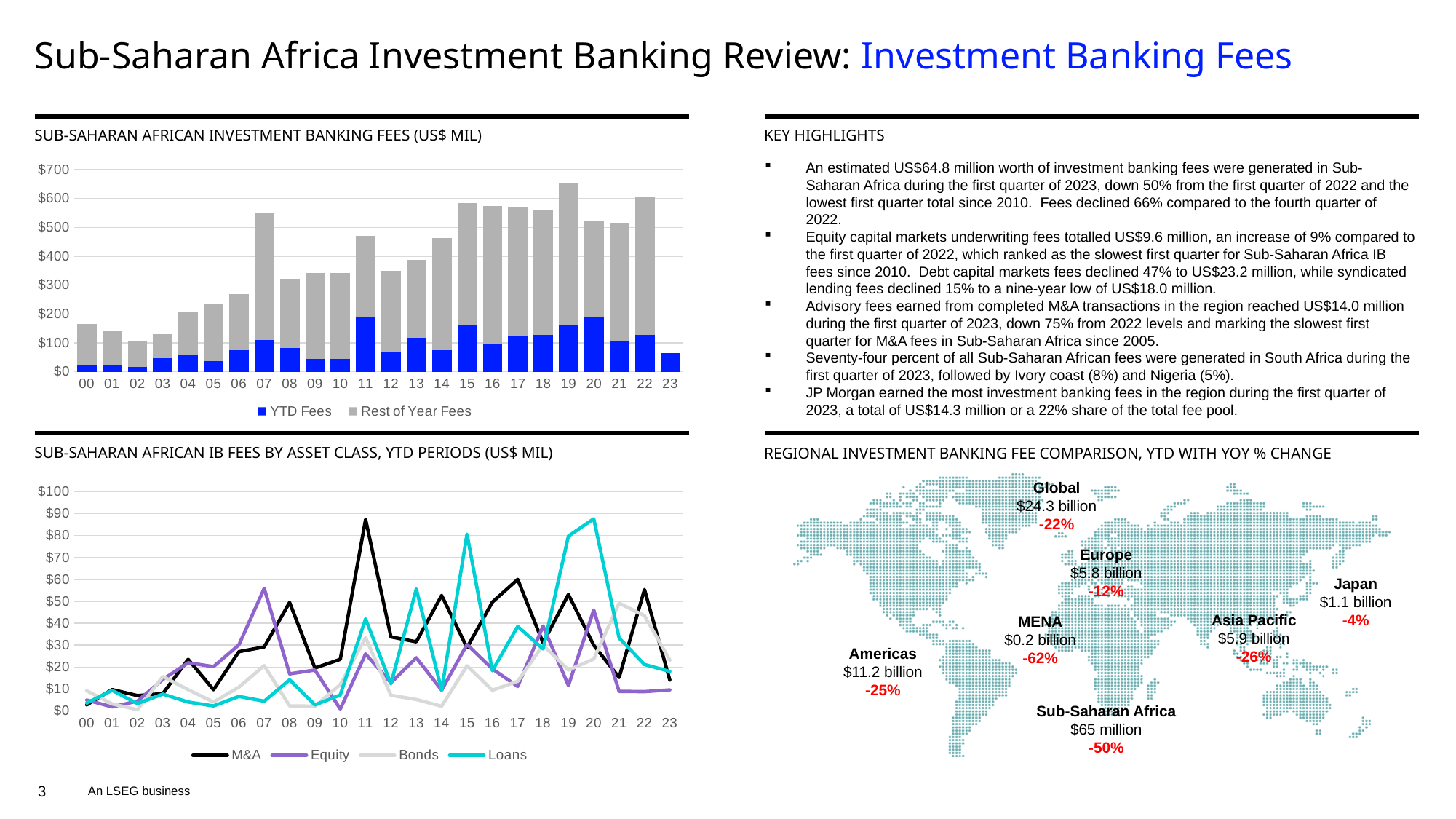
In the top-left chart 'Sub-Saharan African Investment Banking Fees', how many series does the legend list? 2 In the bottom-left chart 'Sub-Saharan African IB Fees by Asset Class', in which year does the M&A line reach its highest value? 11 In the bottom-left chart 'Sub-Saharan African IB Fees by Asset Class', how many years are shown on the x axis? 24 In the bottom-left chart 'Sub-Saharan African IB Fees by Asset Class', is the Loans value for 20 greater or less than $80? greater What type of chart is the top-left chart titled 'Sub-Saharan African Investment Banking Fees (US$ Mil)'? Stacked bar chart In the top-left chart 'Sub-Saharan African Investment Banking Fees', which colour represents YTD Fees? Blue In the bottom-left chart 'Sub-Saharan African IB Fees by Asset Class', which is larger in 07: Equity or M&A? Equity What type of chart is the bottom-left chart titled 'Sub-Saharan African IB Fees by Asset Class, YTD Periods (US$ Mil)'? Line chart In the top-left chart 'Sub-Saharan African Investment Banking Fees', is the total bar for 19 greater or less than $600? greater In the bottom-left chart 'Sub-Saharan African IB Fees by Asset Class', how many series does the legend list? 4 In the top-left chart 'Sub-Saharan African Investment Banking Fees', is the total bar for 02 greater or less than $200? less In the top-left chart 'Sub-Saharan African Investment Banking Fees', which year has the tallest total bar? 19